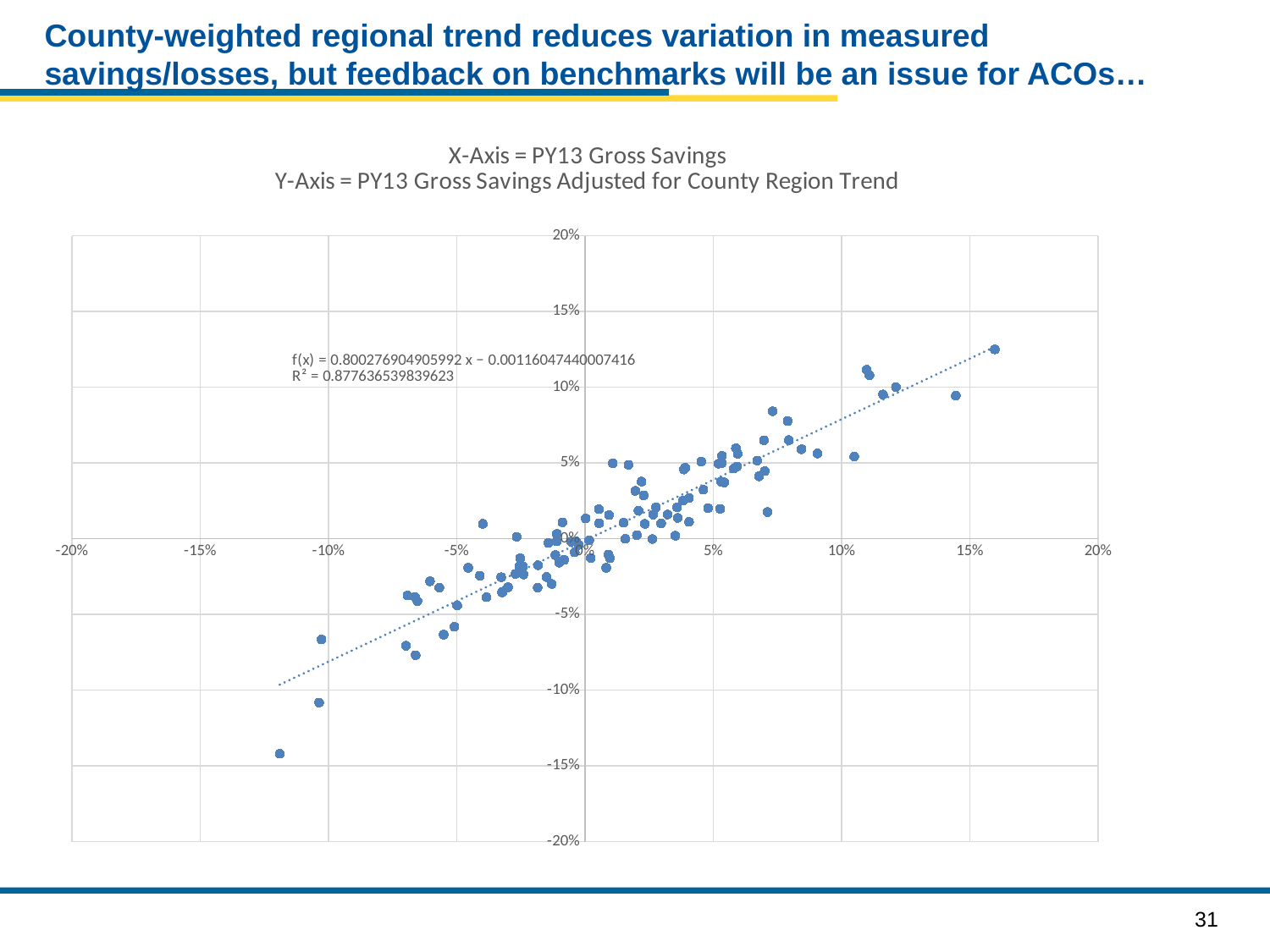
According to the chart title, what does the y axis represent? PY13 Gross Savings Adjusted for County Region Trend Is the y value of the highest plotted point (near x = 16%) greater or less than 10%? greater What is the highest value shown on the y axis? 20% As PY13 Gross Savings on the x axis increases, do the plotted values on the y axis generally rise or fall? Rise What is the slope (coefficient of x) in the fitted line equation printed on the chart? 0.800276904905992 Is the slope of the fitted line printed on the chart greater or less than 1? less Is the y value of the lowest plotted point (near x = -12%) greater or less than -10%? less What R² value is printed on the chart for the fitted line? 0.877636539839623 Is the R² value printed on the chart greater or less than 0.5? greater What kind of chart is shown on the slide? Scatter chart What is the intercept in the fitted line equation printed on the chart? −0.00116047440007416